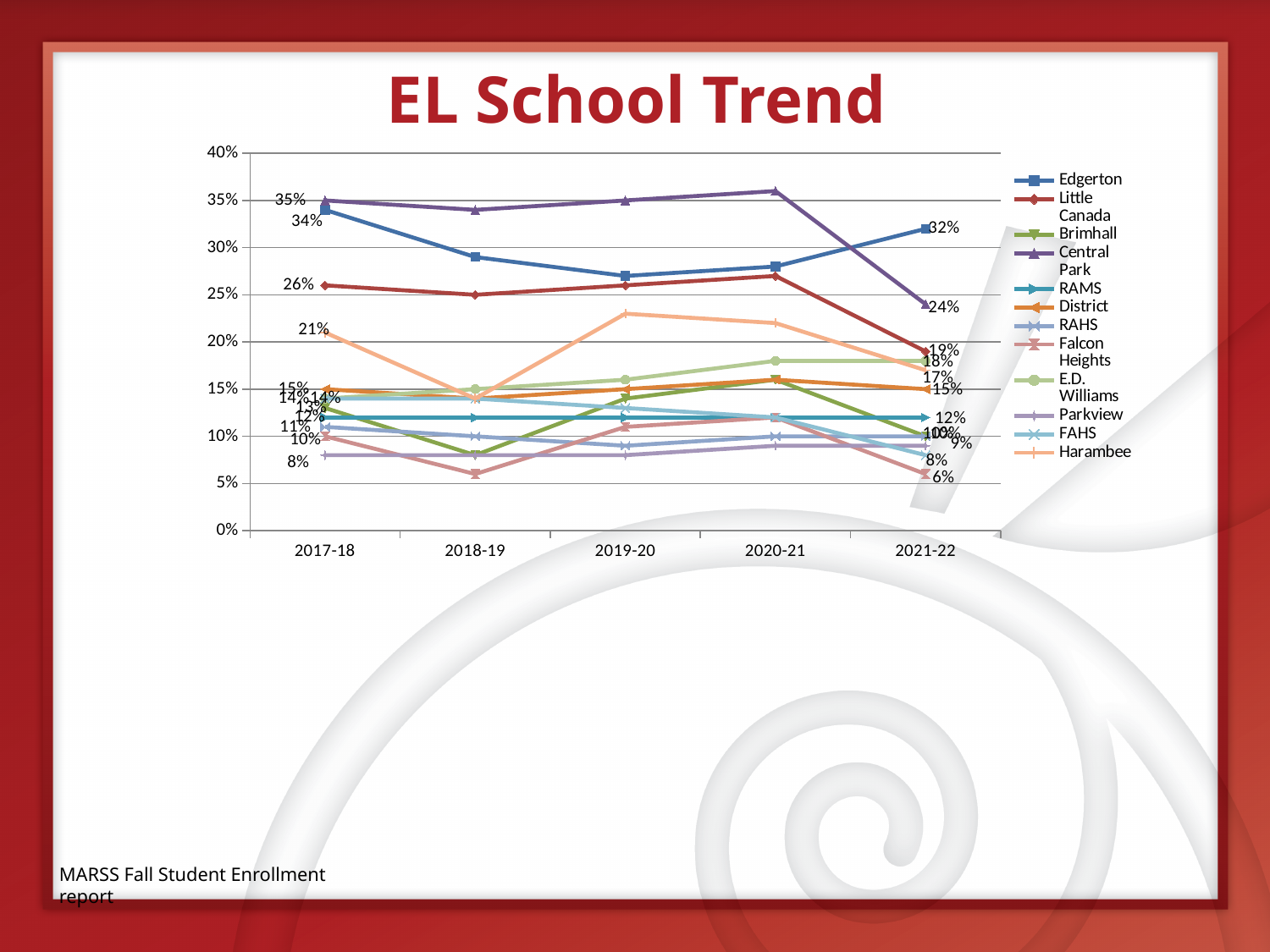
How many series does the legend list? 12 Is the value for Harambee in 2019-20 greater or less than 20%? greater What is the value for Harambee in 2017-18? 21% By how many percentage points did Central Park's value change from 2017-18 (35%) to 2021-22 (24%)? 11 percentage points Which series has the highest value in 2021-22? Edgerton Which series has the lowest value in 2021-22? Falcon Heights What is the value for Central Park in 2017-18? 35% In 2021-22, which is larger: the value for Edgerton or the value for Central Park? Edgerton What is the value for Edgerton in 2021-22? 32% How many school years are shown on the x axis? 5 Does the Little Canada line rise or fall overall from 2017-18 to 2021-22? fall What type of chart is shown on the slide? line chart